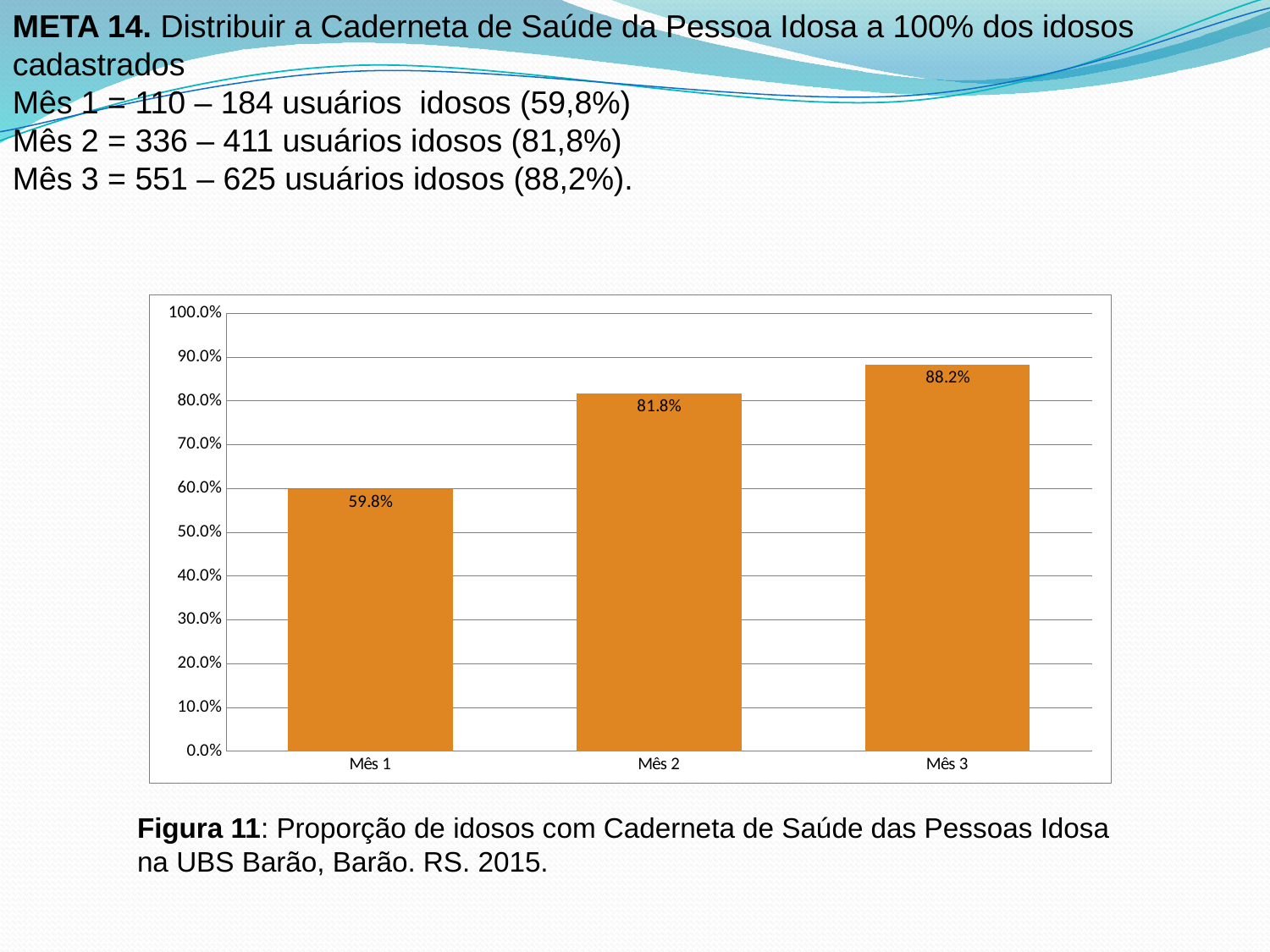
Which month has the highest value? Mês 3 Do the values rise or fall from Mês 1 to Mês 3? rise What is the value for Mês 3? 88.2% What is the difference between the values for Mês 2 and Mês 1? 22.0% What kind of chart is shown on the slide? bar chart Which month has the lowest value? Mês 1 How many categories are shown on the x axis? 3 What is the difference between the values for Mês 3 and Mês 1? 28.4% Which is larger, the value for Mês 2 or the value for Mês 3? Mês 3 What is the value for Mês 1? 59.8% Is the value for Mês 1 greater or less than 70.0%? less What is the value for Mês 2? 81.8%